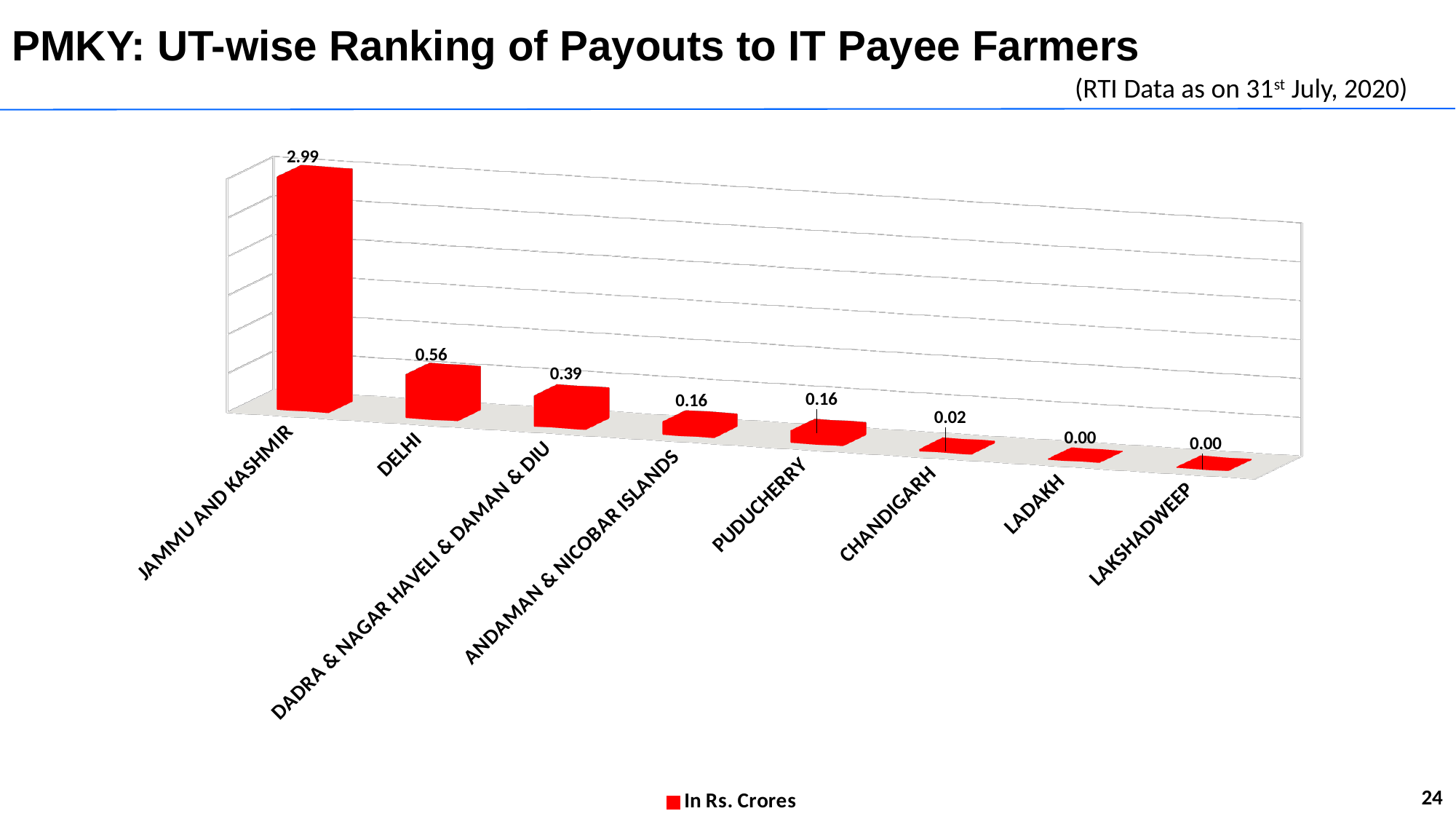
How many UTs are shown on the chart? 8 What is the payout value for Dadra & Nagar Haveli & Daman & Diu? 0.39 What is the payout value for Delhi? 0.56 What unit does the legend give for the values? In Rs. Crores What is the payout value for Jammu and Kashmir? 2.99 Which UT has the highest payout? Jammu and Kashmir What is the difference between the payouts for Jammu and Kashmir and Delhi? 2.43 Which has a larger payout, Delhi or Puducherry? Delhi What is the payout value for Chandigarh? 0.02 What kind of chart is shown on the slide? Bar chart How many series does the legend list? 1 What is the difference between the payouts for Delhi and Dadra & Nagar Haveli & Daman & Diu? 0.17